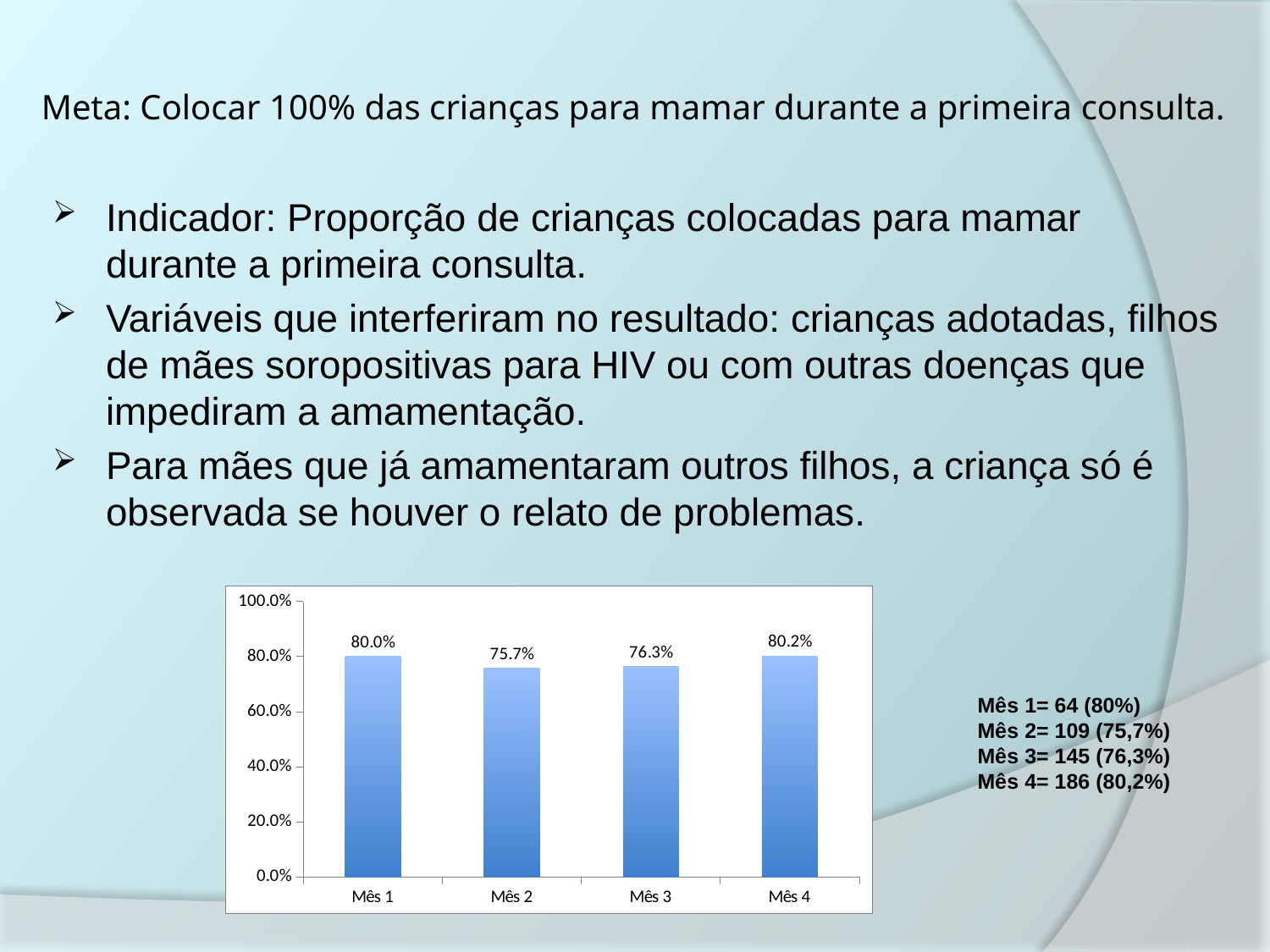
What is the value shown for Mês 1? 80.0% What is the value shown for Mês 3? 76.3% Which is larger, the value for Mês 1 or the value for Mês 2? Mês 1 What is the value shown for Mês 2? 75.7% What is the highest value marked on the y axis of the chart? 100.0% How many months (categories) are shown on the x axis of the chart? 4 Is the value for Mês 3 greater or less than 80.0%? less Which month has the lowest value in the chart? Mês 2 What is the difference between the values for Mês 3 and Mês 2? 0.6% Which month has the highest value in the chart? Mês 4 What is the value shown for Mês 4? 80.2% What kind of chart is shown on the slide? bar chart